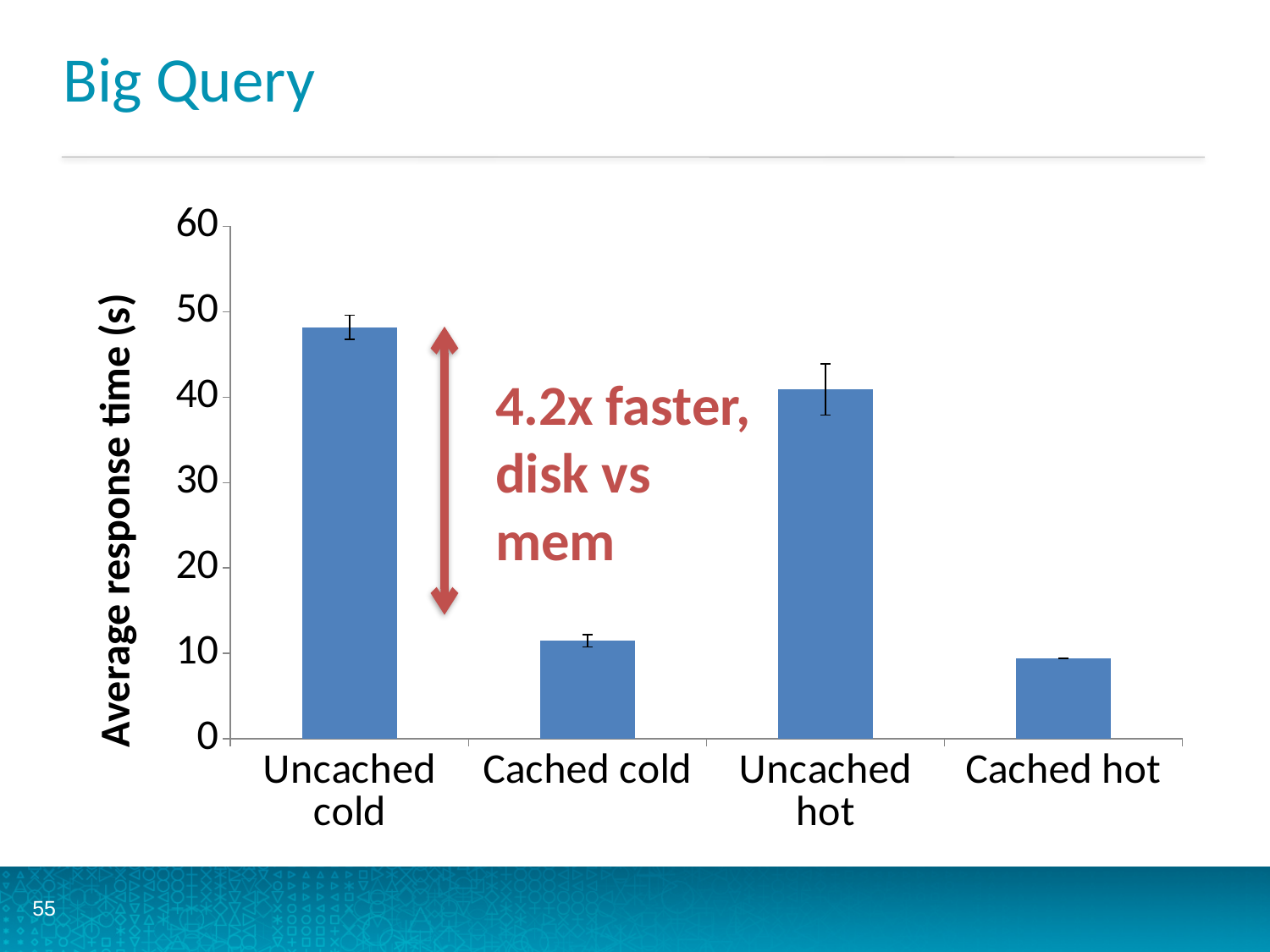
Which has a larger average response time, Cached cold or Uncached hot? Uncached hot Which category has the lowest average response time? Cached hot Which category has the highest average response time? Uncached cold What is the label on the y axis of the chart? Average response time (s) Is the value for Uncached hot greater or less than 50? less Is the value for Cached cold greater or less than 10? greater Is the value for Uncached cold greater or less than 50? less What kind of chart is shown on the slide? bar chart Which has a larger average response time, Uncached cold or Uncached hot? Uncached cold How many categories are shown on the x axis of the chart? 4